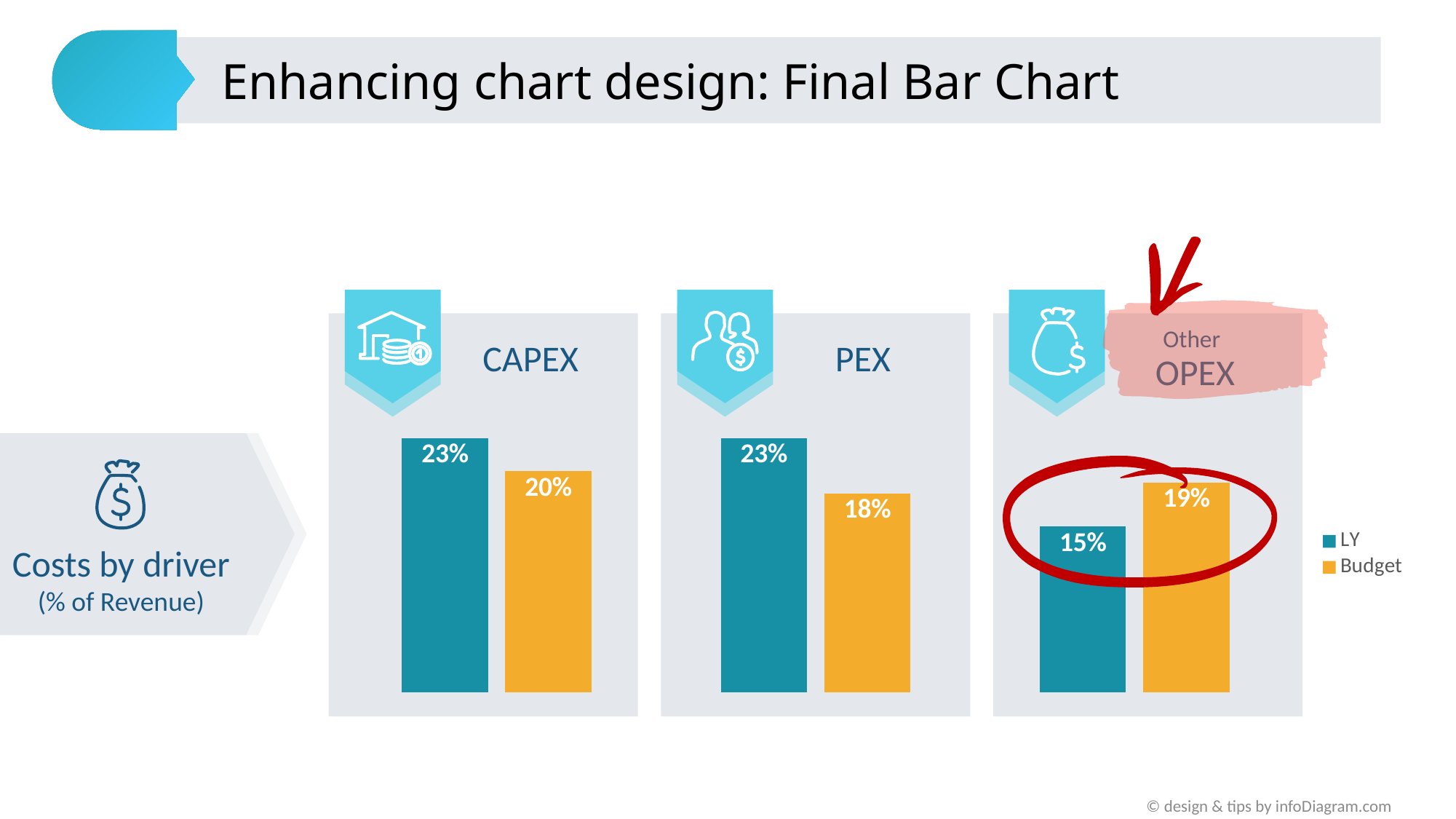
Which category has the lowest LY value? Other OPEX What type of chart is shown on the slide? Bar chart What is the LY value for CAPEX? 23% How many series does the legend list? 2 What is the LY value for Other OPEX? 15% What is the difference between the Budget and LY values for Other OPEX? 4% What is the Budget value for Other OPEX? 19% How many categories are shown in the chart? 3 What is the difference between the LY and Budget values for PEX? 5% What is the Budget value for PEX? 18% For Other OPEX, which is larger: the LY value or the Budget value? Budget Which category has the highest Budget value? CAPEX